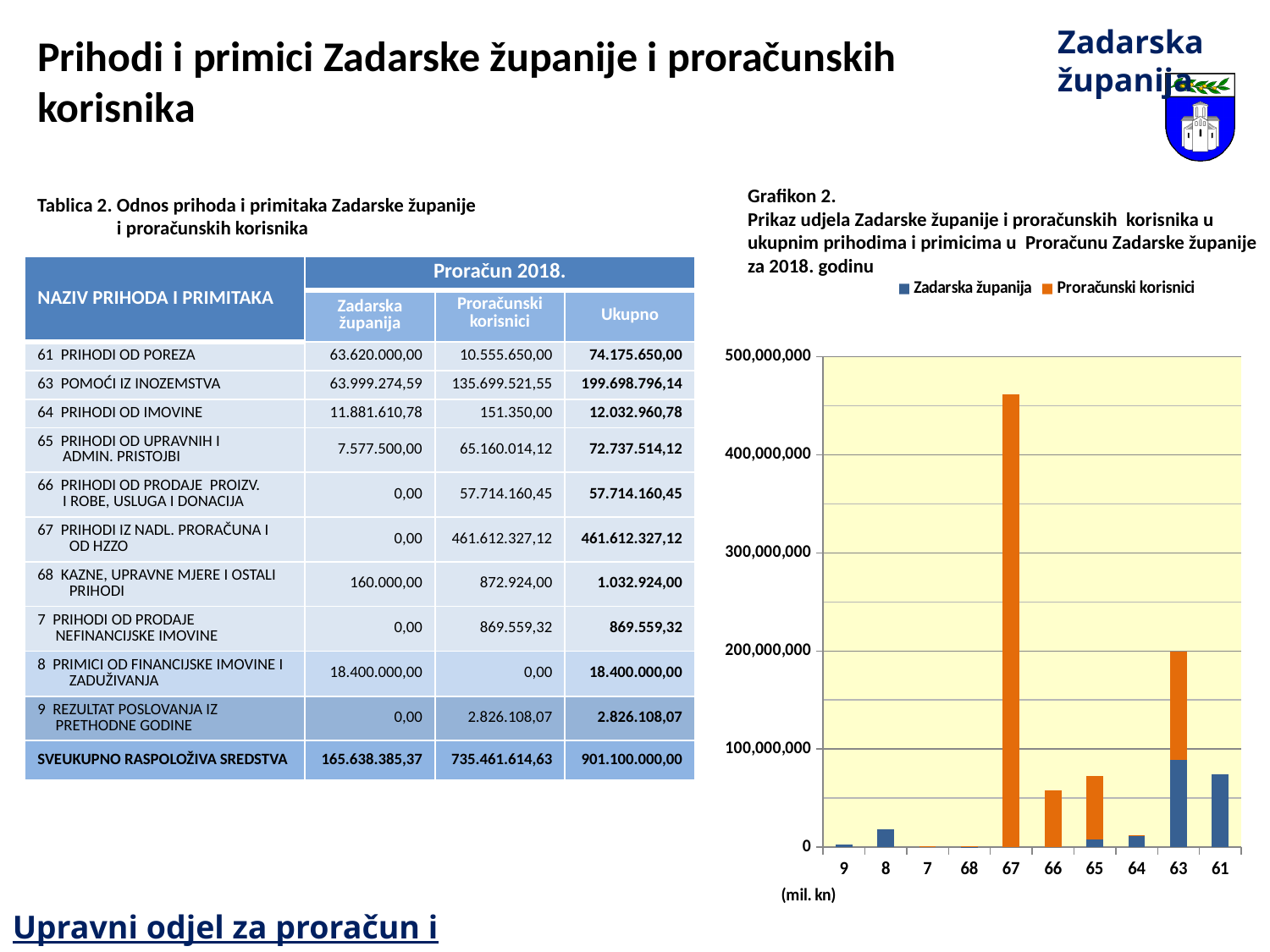
In Grafikon 2, which bar is taller: category 65 or category 66? 65 In Grafikon 2, is the value for category 67 greater or less than 400,000,000? greater What kind of chart is Grafikon 2 on the slide? bar chart In Grafikon 2, is the value for category 64 greater or less than 100,000,000? less In Grafikon 2, which series makes up the entire bar for category 67? Proračunski korisnici In Grafikon 2, which series is shown in orange? Proračunski korisnici In Grafikon 2, is the total bar for category 63 greater or less than 100,000,000? greater How many categories are shown on the x axis of Grafikon 2? 10 How many series does the legend of Grafikon 2 list? 2 In Grafikon 2, which category has the tallest bar? 67 In Grafikon 2, which bar is taller: category 8 or category 9? 8